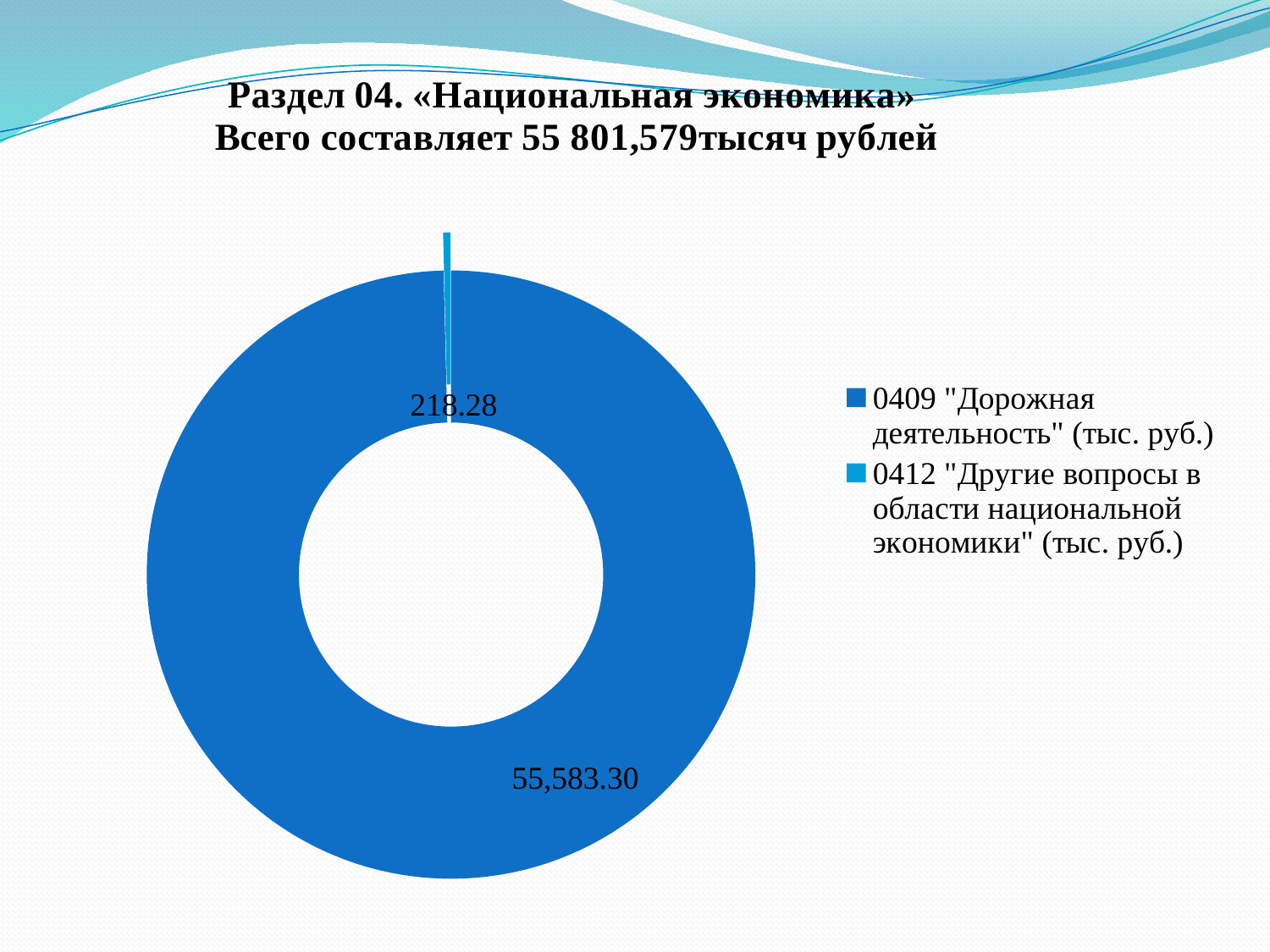
Which category has the largest slice of the chart? 0409 "Дорожная деятельность" (тыс. руб.) What kind of chart is shown on the slide? doughnut chart What is the difference between the value for 0409 "Дорожная деятельность" and the value for 0412 "Другие вопросы в области национальной экономики"? 55,365.02 Which is larger, the value for 0409 "Дорожная деятельность" or the value for 0412 "Другие вопросы в области национальной экономики"? 0409 "Дорожная деятельность" How many entries does the legend list? 2 What is the value for 0412 "Другие вопросы в области национальной экономики" (тыс. руб.)? 218.28 How many categories (slices) does the chart have? 2 Which legend entry is shown in the lighter blue colour? 0412 "Другие вопросы в области национальной экономики" (тыс. руб.) Which category has the smallest slice of the chart? 0412 "Другие вопросы в области национальной экономики" (тыс. руб.) According to the slide title, what is the total amount for Раздел 04 «Национальная экономика»? 55 801,579 тысяч рублей What is the value for 0409 "Дорожная деятельность" (тыс. руб.)? 55,583.30 What is the total of the two values shown on the chart? 55,801.58